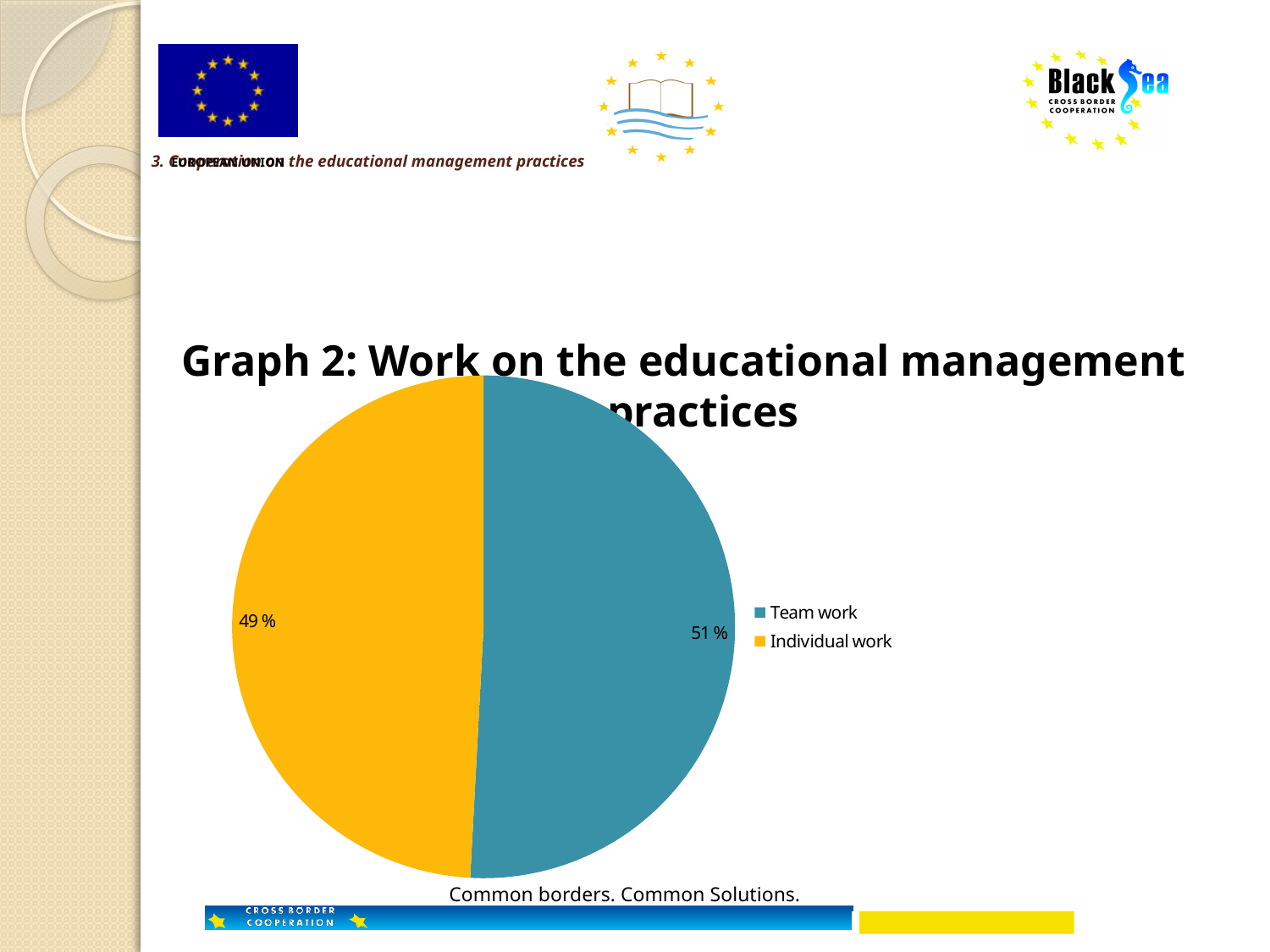
What percentage of the pie is Team work? 51 % Which slice of the pie is the largest? Team work What colour is the Individual work slice? orange What is the difference between the Team work and Individual work percentages? 2 % What is the title of the chart? Graph 2: Work on the educational management practices How many entries does the legend list? 2 How many slices does the pie chart have? 2 What is the share of the pie taken by Team work? 51 % What percentage of the pie is Individual work? 49 % What kind of chart is shown on the slide? pie chart Which slice of the pie is the smallest? Individual work Which is larger, Team work or Individual work? Team work